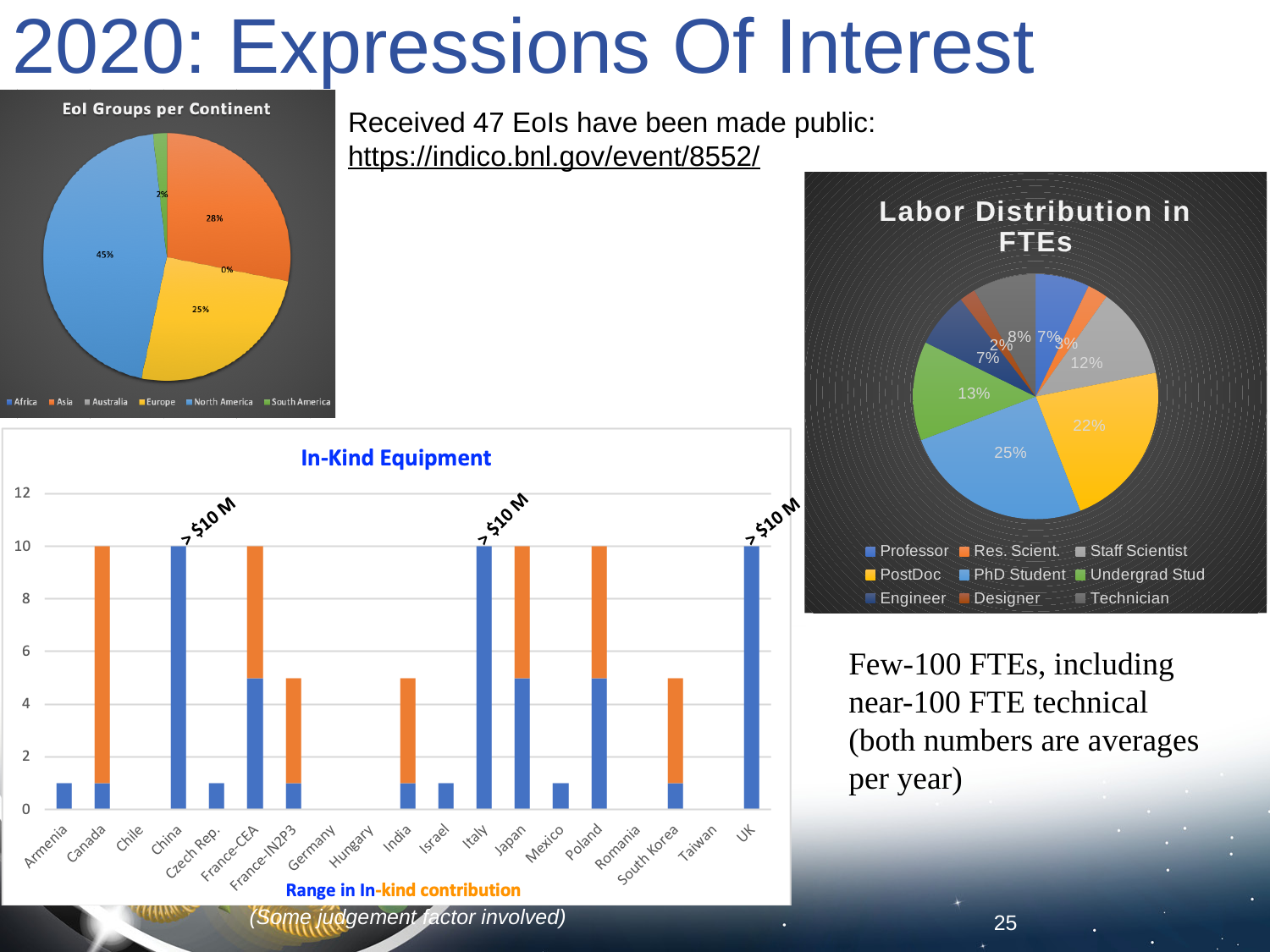
In the 'Labor Distribution in FTEs' pie chart, which category has the largest share? PhD Student In the 'In-Kind Equipment' chart, is the value for Armenia greater or less than 2? less In the 'Labor Distribution in FTEs' pie chart, what percentage is shown for PhD Student? 25% In the 'Labor Distribution in FTEs' pie chart, what percentage is shown for PostDoc? 22% What kind of chart is the 'In-Kind Equipment' chart? Bar chart How many categories does the legend of the 'Labor Distribution in FTEs' pie chart list? 9 How many countries/institutions are listed on the x axis of the 'In-Kind Equipment' chart? 19 In the 'EoI Groups per Continent' pie chart, how many percentage points larger is Asia's share than Europe's? 3 percentage points In the 'EoI Groups per Continent' pie chart, which continent has the largest share? North America In the 'EoI Groups per Continent' pie chart, which has the larger share, Europe or Asia? Asia In the 'EoI Groups per Continent' pie chart, what percentage is shown for Asia? 28% In the 'EoI Groups per Continent' pie chart, what percentage is shown for North America? 45%